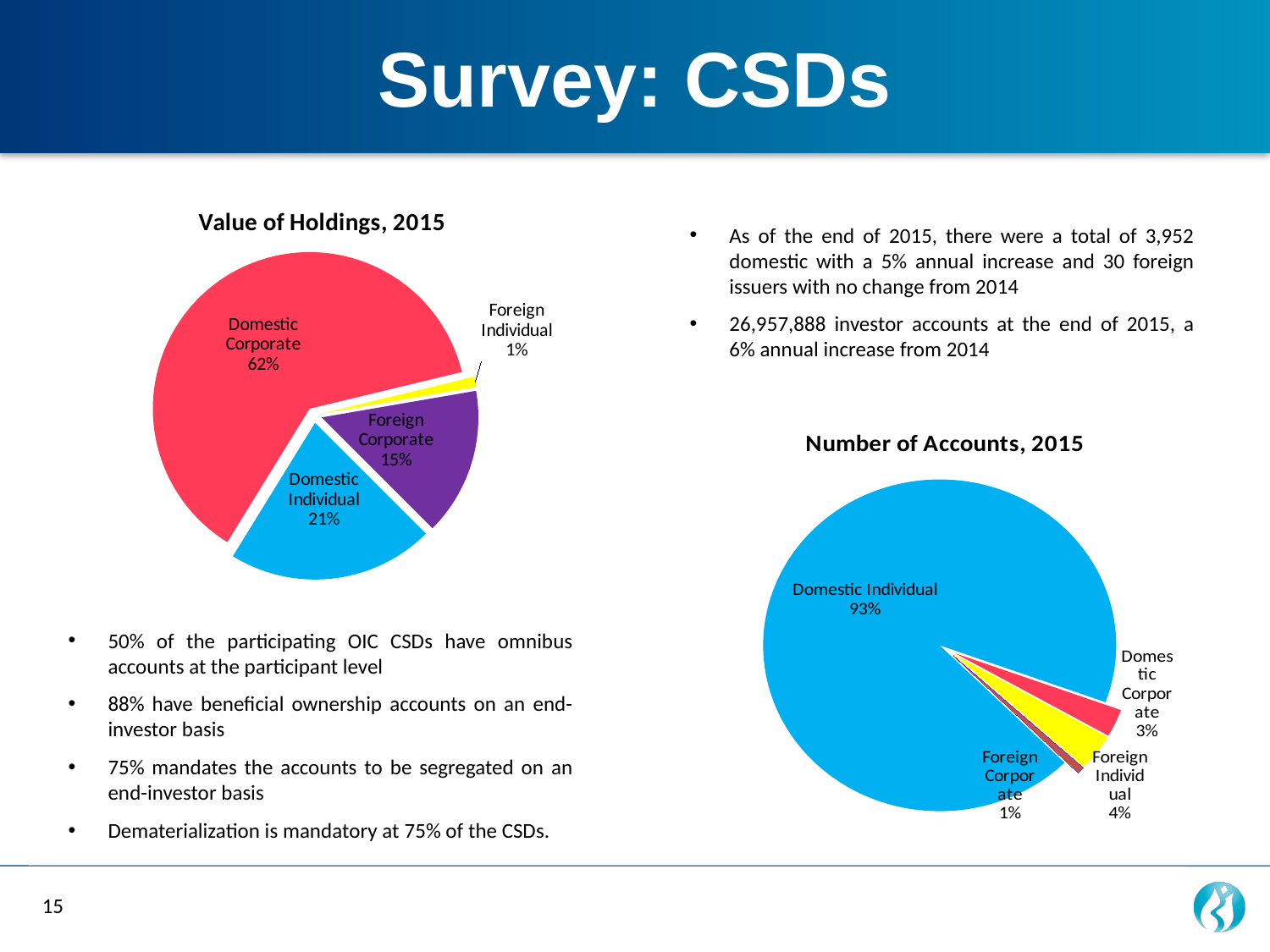
In the 'Number of Accounts, 2015' chart, which category has the smallest share? Foreign Corporate In the 'Value of Holdings, 2015' chart, what share does Domestic Corporate hold? 62% In the 'Number of Accounts, 2015' chart, what share does Domestic Individual hold? 93% In the 'Value of Holdings, 2015' chart, how many percentage points larger is Domestic Individual than Foreign Corporate? 6 In the 'Value of Holdings, 2015' chart, which category has the smallest share? Foreign Individual In the 'Value of Holdings, 2015' chart, what share does Foreign Corporate hold? 15% In the 'Value of Holdings, 2015' chart, which category has the largest share? Domestic Corporate How many slices does the 'Number of Accounts, 2015' pie chart have? 4 What kind of chart is 'Value of Holdings, 2015'? Pie chart In the 'Number of Accounts, 2015' chart, which is larger, Domestic Corporate or Foreign Individual? Foreign Individual